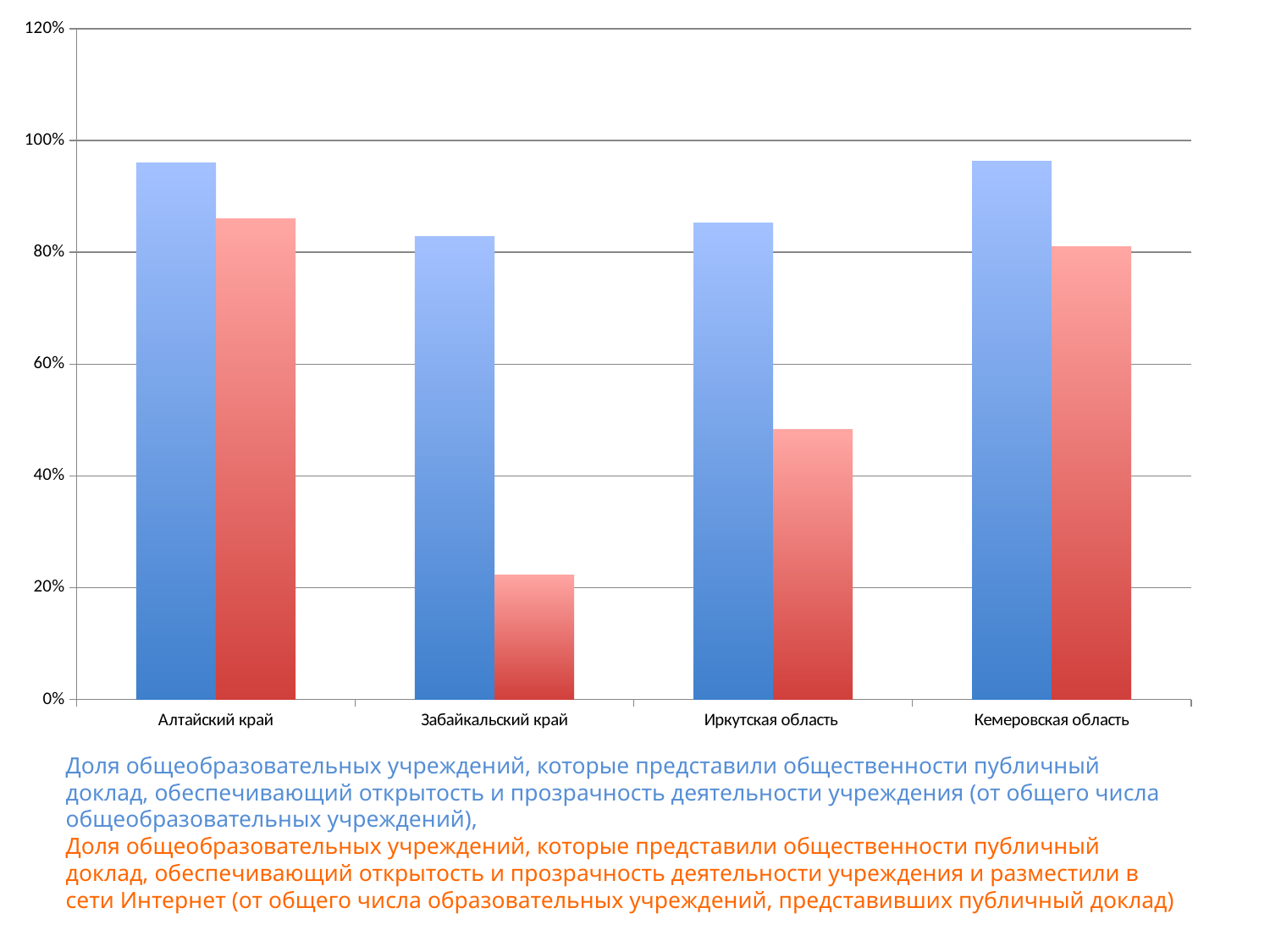
Is the red bar for Алтайский край greater or less than 80%? greater Is the red bar for Иркутская область greater or less than 60%? less Is the red bar for Забайкальский край greater or less than 40%? less Which region has a larger red bar: Кемеровская область or Иркутская область? Кемеровская область How many regions (categories) are shown on the x axis of the chart? 4 What kind of chart is shown on the slide? bar chart Which is larger for Иркутская область: the blue bar or the red bar? the blue bar What is the highest value shown on the vertical axis of the chart? 120% Which region has the lowest red bar? Забайкальский край Which region has a larger red bar: Забайкальский край or Иркутская область? Иркутская область